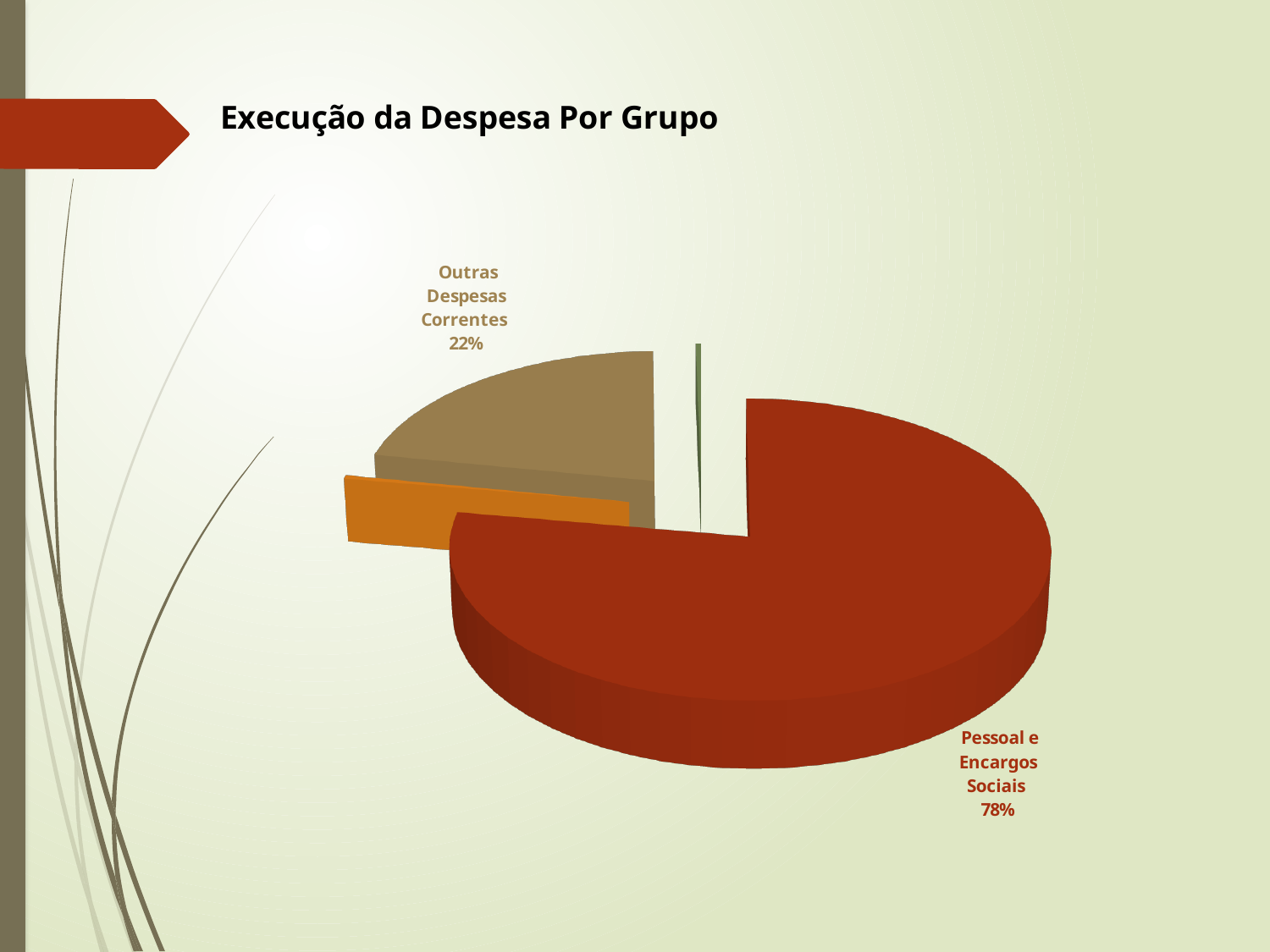
What share of the pie does Outras Despesas Correntes represent? 22% What colour is the Pessoal e Encargos Sociais slice? red Is the share for Pessoal e Encargos Sociais greater or less than 75%? greater Which labeled category has the smaller share, Pessoal e Encargos Sociais or Outras Despesas Correntes? Outras Despesas Correntes What kind of chart is shown on the slide? pie chart What is the difference in percentage points between the Pessoal e Encargos Sociais share and the Outras Despesas Correntes share? 56 percentage points What is the title of the slide? Execução da Despesa Por Grupo Which labeled category has the largest share of the pie? Pessoal e Encargos Sociais Is the share for Outras Despesas Correntes greater or less than 25%? less Is the share for Pessoal e Encargos Sociais larger or smaller than the share for Outras Despesas Correntes? larger What share of the pie does Pessoal e Encargos Sociais represent? 78%